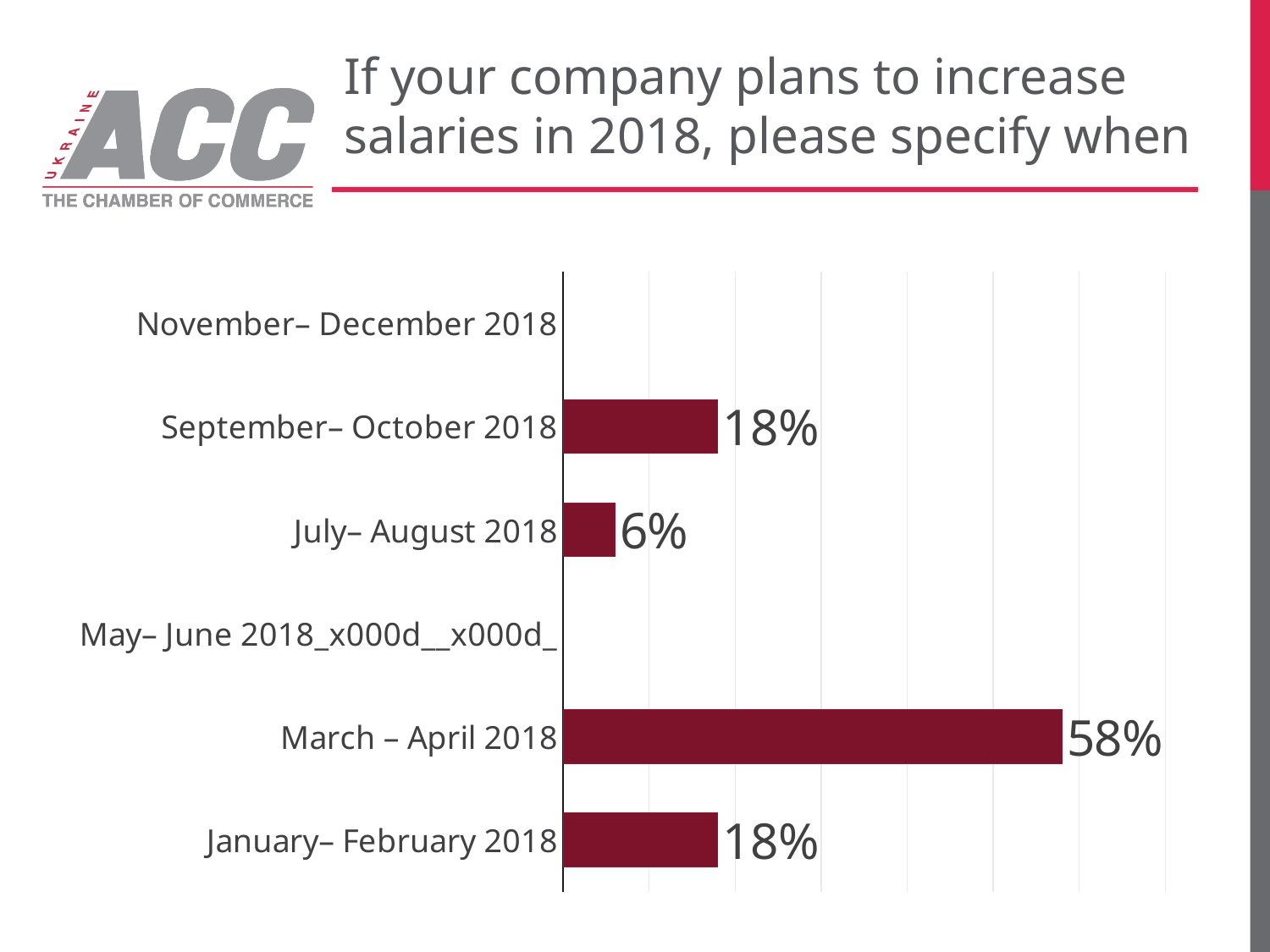
Among the periods with a labelled bar, which has the lowest percentage? July– August 2018 What percentage of companies plan to increase salaries in March – April 2018? 58% What type of chart is shown on the slide? Bar chart What is the difference between the values for January– February 2018 and July– August 2018? 12% How many time periods are listed on the chart? 6 What is the value shown for July– August 2018? 6% What is the value shown for September– October 2018? 18% Which is larger, the value for July– August 2018 or the value for September– October 2018? September– October 2018 What is the difference between the values for March – April 2018 and September– October 2018? 40% What colour are the bars in the chart? Dark red What is the value shown for January– February 2018? 18% Which period has the highest percentage? March – April 2018